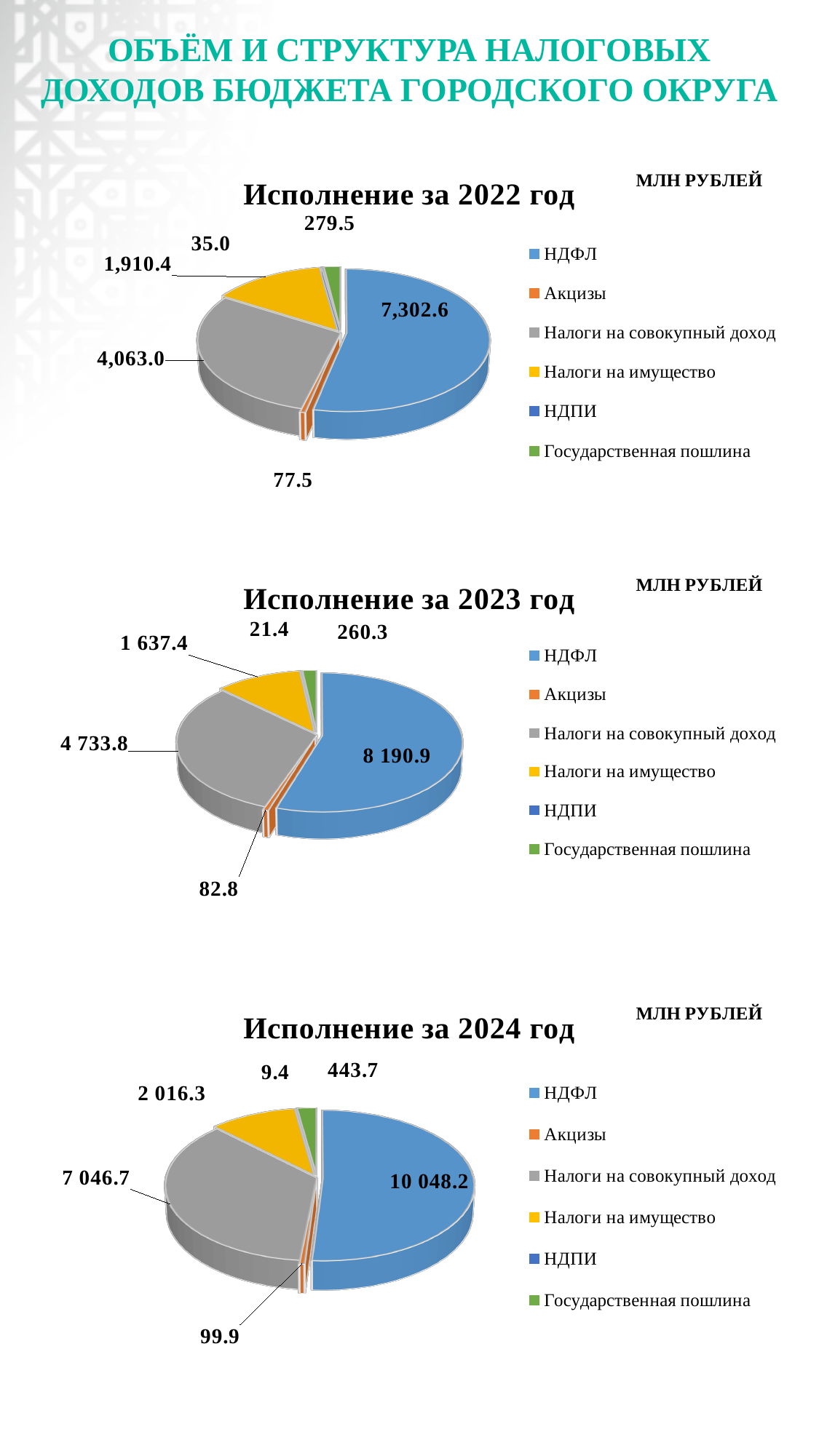
In the chart 'Исполнение за 2024 год', which category has the smallest value? НДПИ What unit is indicated next to the chart 'Исполнение за 2024 год'? МЛН РУБЛЕЙ How many categories does the legend of the chart 'Исполнение за 2023 год' list? 6 In the chart 'Исполнение за 2024 год', what is the value for Государственная пошлина? 443.7 In the chart 'Исполнение за 2024 год', what is the value for Налоги на имущество? 2 016.3 In the chart 'Исполнение за 2023 год', what is the value for Налоги на совокупный доход? 4 733.8 In the chart 'Исполнение за 2022 год', what is the value for НДФЛ? 7,302.6 In the chart 'Исполнение за 2023 год', which category has the largest value? НДФЛ What type of chart is 'Исполнение за 2022 год'? Pie chart In the chart 'Исполнение за 2022 год', which is larger: Акцизы or Государственная пошлина? Государственная пошлина In the chart 'Исполнение за 2024 год', what is the difference between НДФЛ and Налоги на совокупный доход? 3 001.5 In the chart 'Исполнение за 2022 год', what is the value for НДПИ? 35.0